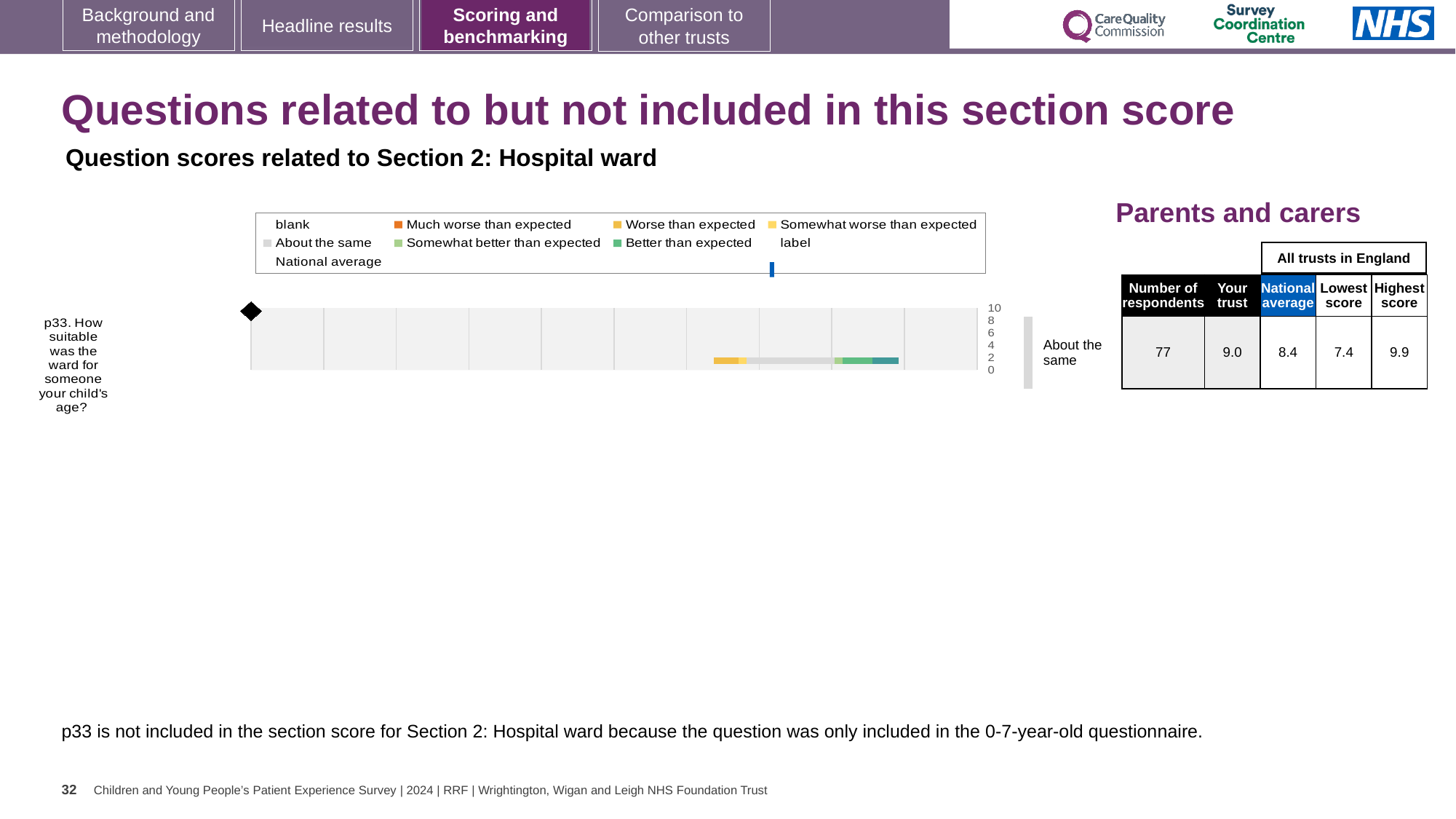
What is the difference between the Your trust score and the National average for p33? 0.6 Which is larger for p33: the Your trust score or the National average? Your trust What is the National average score for p33 in the Parents and carers table? 8.4 What kind of chart is used to show the p33 question score? Bar chart Is the Lowest score for p33 greater or less than 8? less Which question is plotted in the chart? p33. How suitable was the ward for someone your child's age? What is the difference between the Highest score and the Lowest score for p33 in the table? 2.5 How many questions (categories) are plotted in the chart? 1 How many respondents answered p33 according to the table? 77 What is the highest tick value shown on the chart's score axis? 10 What benchmark category label is shown to the right of the p33 bar? About the same What is the 'Your trust' score for p33 in the Parents and carers table? 9.0